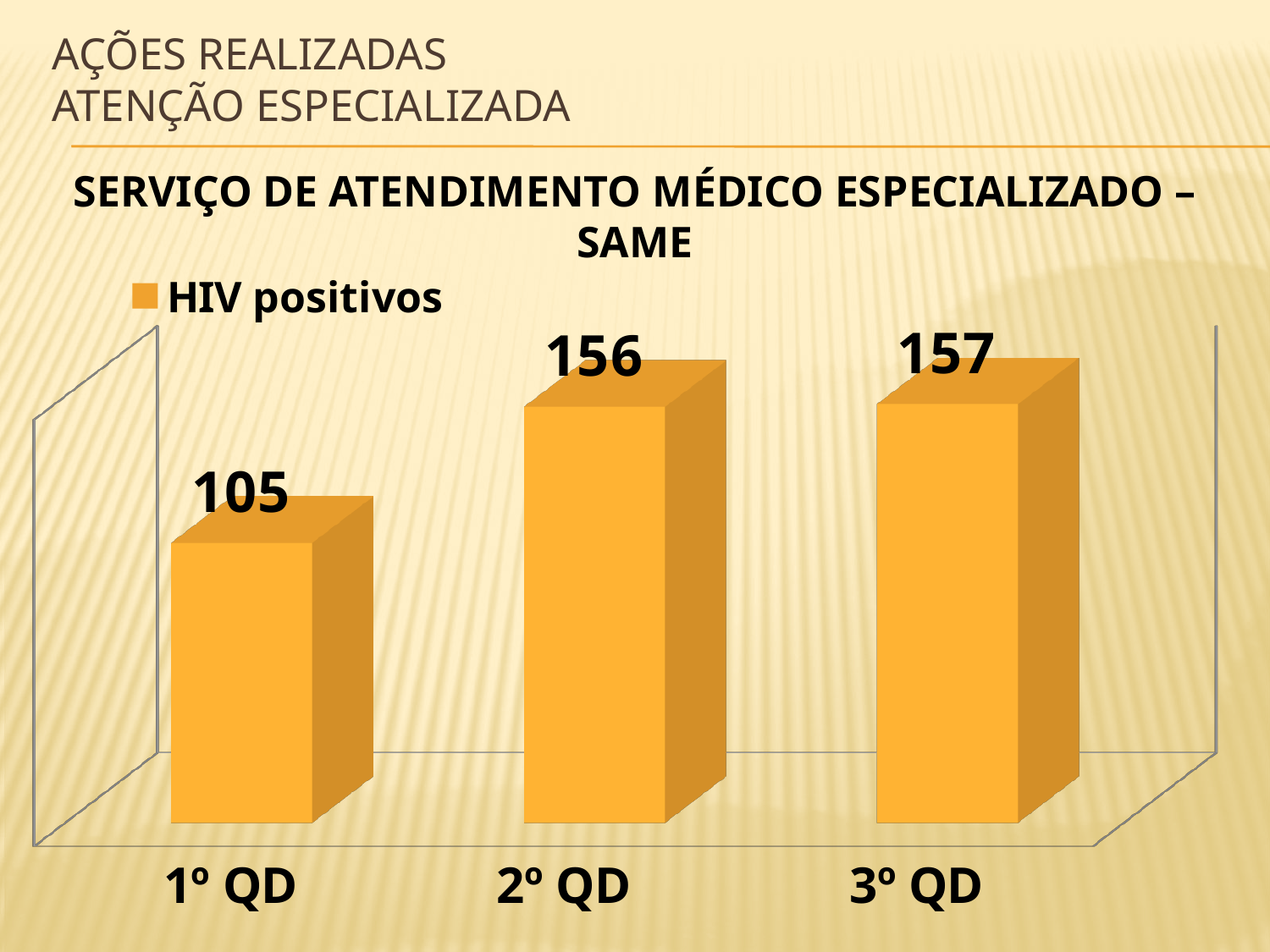
Do the values rise or fall from 1º QD to 3º QD? rise What is the value for 3º QD? 157 What is the value for 1º QD? 105 Which category has the lowest value? 1º QD What is the difference between the values for 3º QD and 2º QD? 1 What is the value for 2º QD? 156 How many series does the legend list? 1 How many categories are shown on the x axis? 3 What is the difference between the values for 2º QD and 1º QD? 51 Which is larger, the value for 1º QD or the value for 3º QD? 3º QD What kind of chart is shown on the slide? bar chart What is the name of the series shown in the legend? HIV positivos